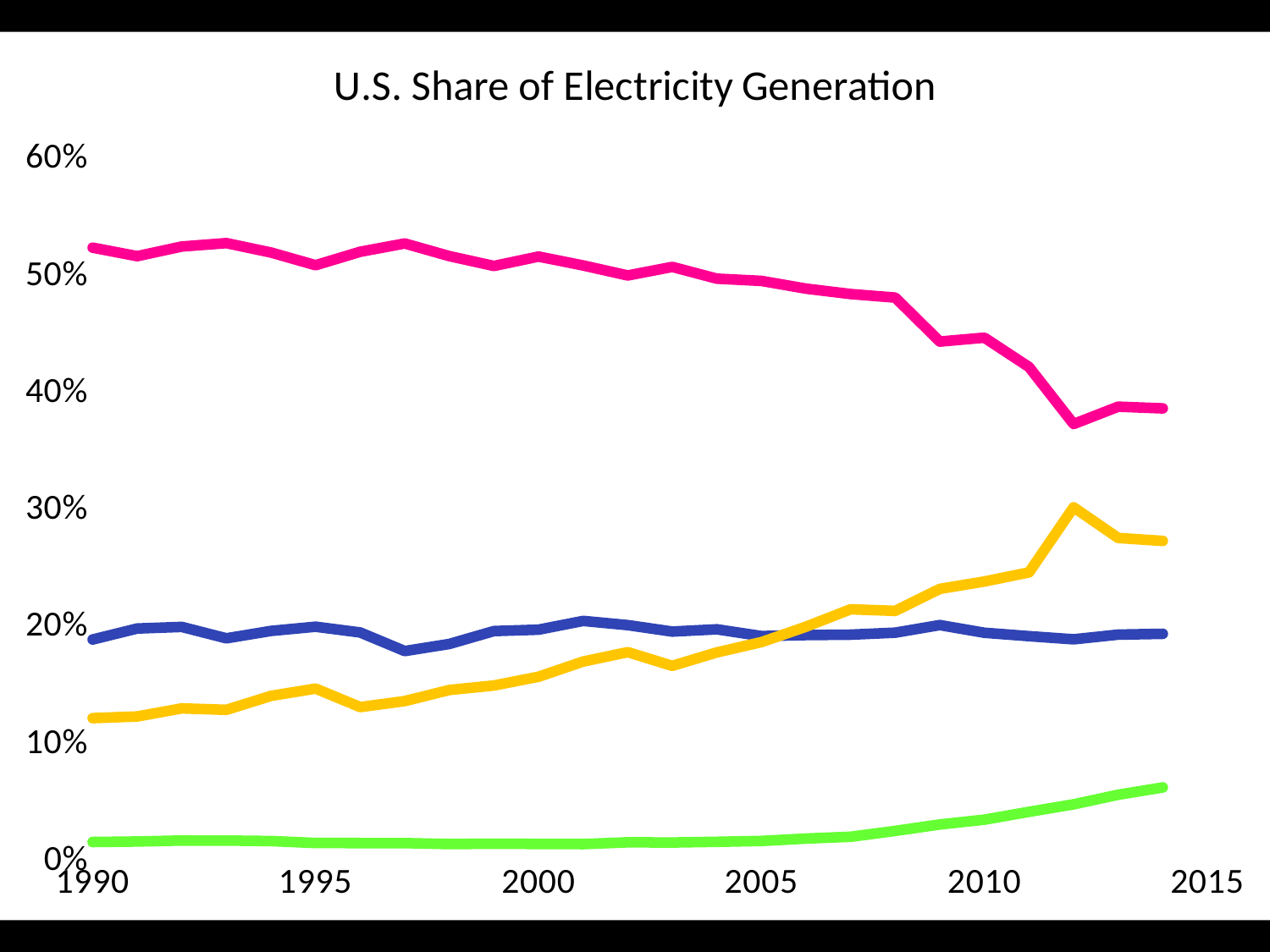
Does the pink line rise or fall overall from 1990 to 2014? fall What is the title of the chart? U.S. Share of Electricity Generation Is the value of the pink line in 1990 greater or less than 50%? greater Does the green line rise or fall overall from 1990 to 2014? rise Is the value of the pink line in 2014 greater or less than 40%? less What kind of chart is shown on the slide? line chart Which line has the highest value in 1990? the pink line In 2014, which is larger: the yellow line or the blue line? the yellow line Is the value of the green line in 2014 greater or less than 10%? less How many lines are plotted on the chart? 4 Does the yellow line rise or fall overall from 1990 to 2014? rise